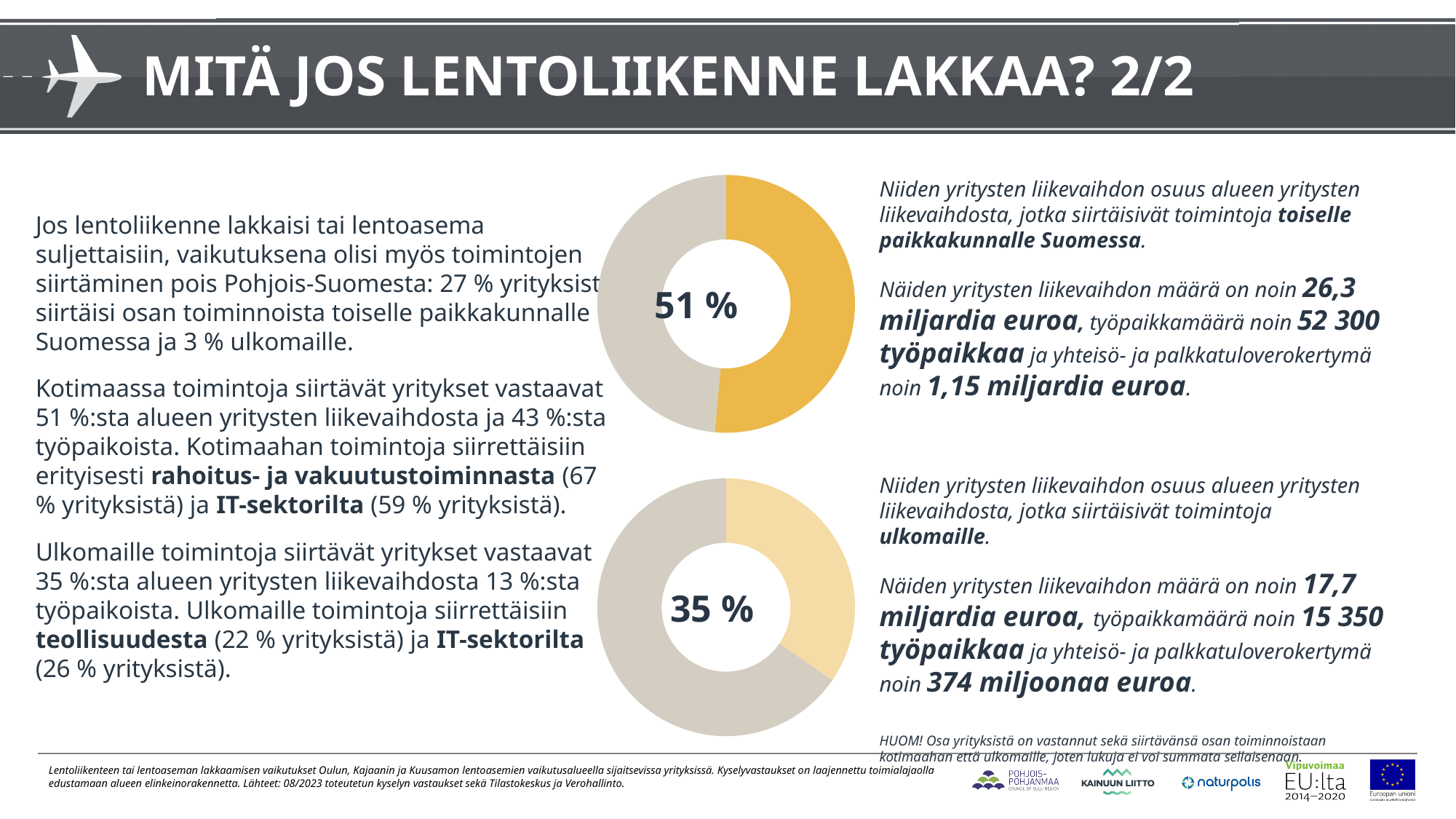
In the lower pie chart, is the coloured slice larger or smaller than the grey slice? smaller Which of the two pie charts shows the larger highlighted share, the upper or the lower one? the upper one In the upper pie chart, is the coloured slice greater or less than 50 %? greater What colour is the highlighted slice in the upper pie chart? orange What is the difference between the percentage shown in the upper pie chart and the percentage shown in the lower pie chart? 16 % In the lower pie chart, is the coloured slice greater or less than 50 %? less What percentage is printed in the centre of the lower pie chart? 35 % What kind of chart is the lower chart on the slide? doughnut chart How many slices does the lower pie chart have? 2 What percentage is printed in the centre of the upper pie chart? 51 % What kind of chart is the upper chart on the slide? doughnut chart How many slices does the upper pie chart have? 2